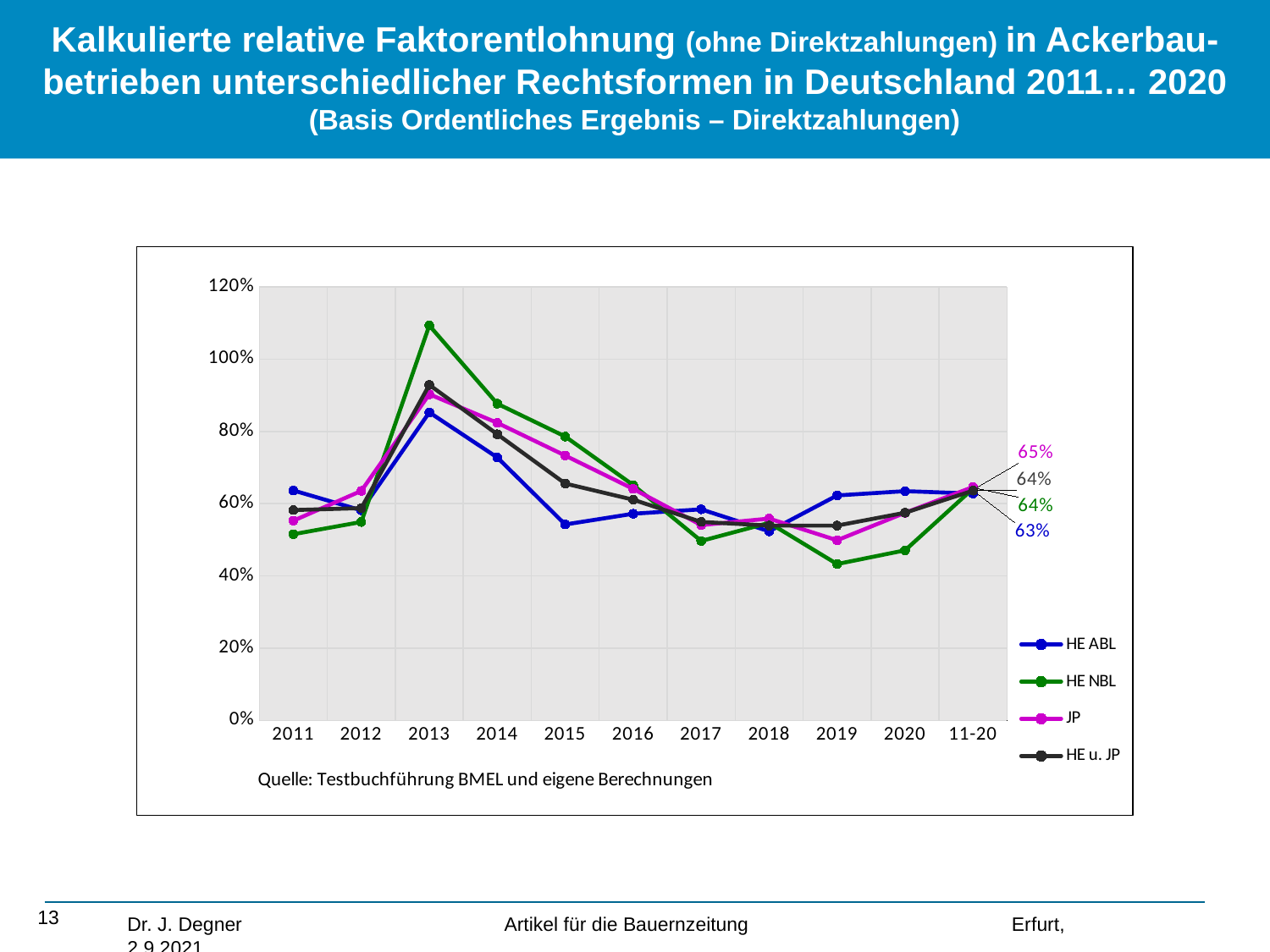
Which series has the highest value in 2013? HE NBL What is the value for HE NBL at 11-20? 64% What is the value for HE ABL at 11-20? 63% In which year does HE NBL reach its highest value? 2013 Does the HE NBL line rise or fall from 2013 to 2015? fall What is the difference between the JP and HE ABL values at 11-20? 2 percentage points How many points are shown along the x axis? 11 Is the value for HE NBL in 2013 greater or less than 100%? greater How many series does the legend list? 4 What kind of chart is shown on the slide? line chart What is the value for JP at 11-20? 65% Is the value for HE NBL in 2019 greater or less than 60%? less